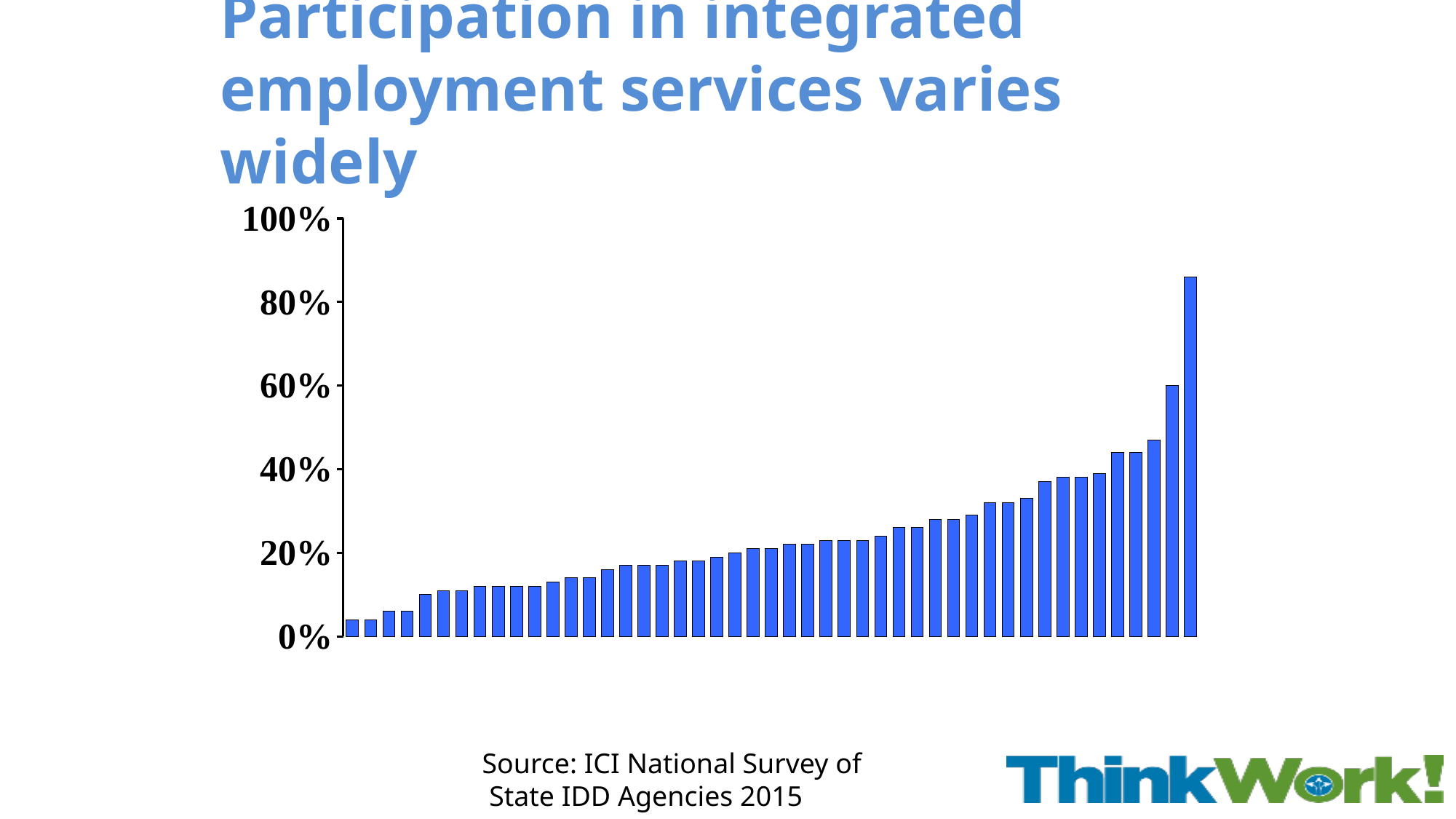
What is the highest value shown on the y axis? 100% Is the value of the leftmost bar greater or less than 20%? less Do the bar values rise or fall from left to right along the x axis? rise What kind of chart is shown on the slide? bar chart Is the value of the tallest (rightmost) bar greater or less than 80%? greater Which bar is the highest: the leftmost bar or the rightmost bar? the rightmost bar What is the title of the chart on the slide? Participation in integrated employment services varies widely Is the value of the tallest bar greater or less than 60%? greater